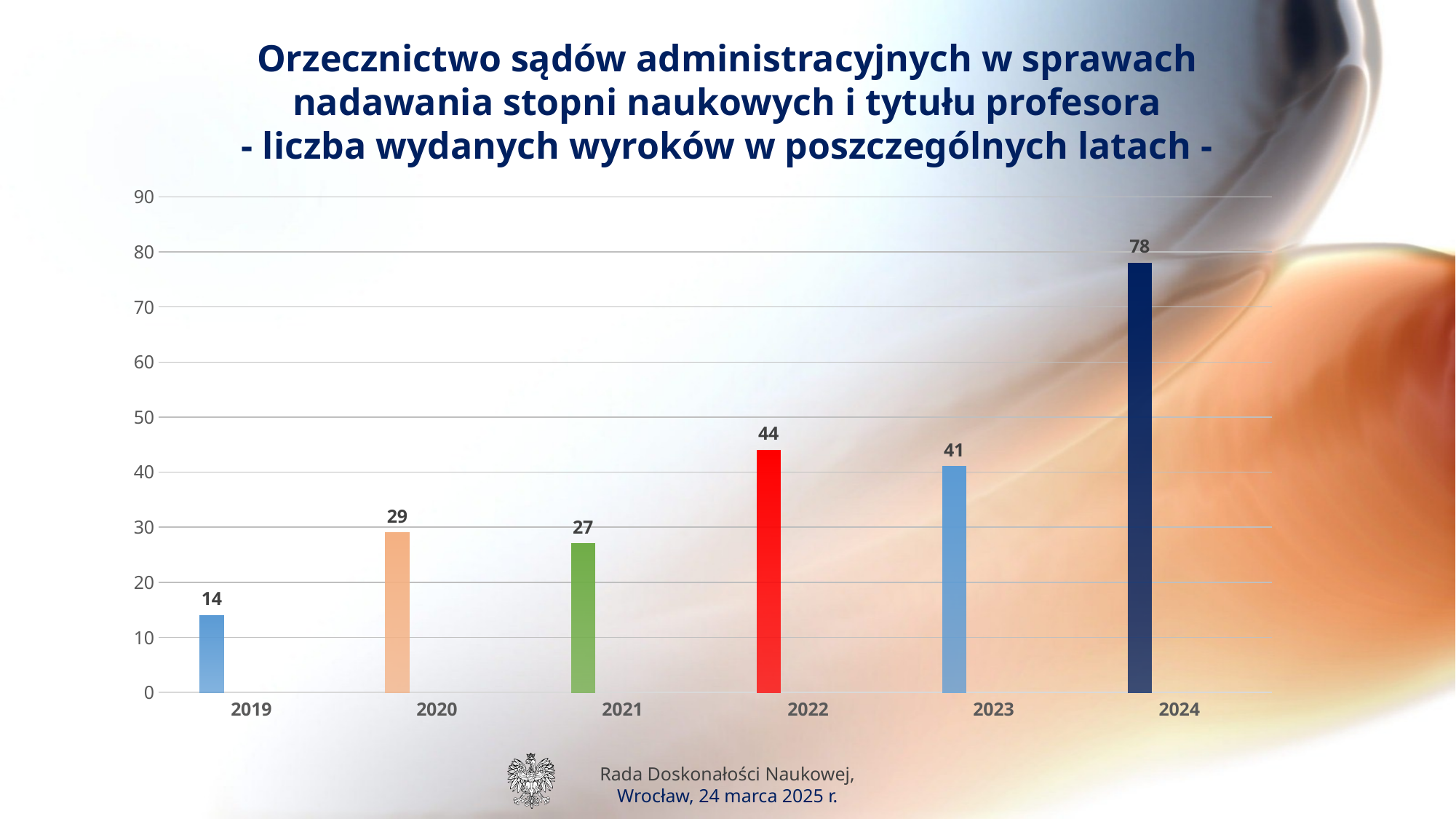
What colour is the bar for 2022? red What is the difference between the values for 2020 and 2021? 2 What kind of chart is shown on the slide? bar chart Is the value for 2024 greater or less than 70? greater Which is larger, the value for 2022 or the value for 2023? 2022 What is the difference between the values for 2024 and 2023? 37 Which year has the lowest value? 2019 Which year has the highest value? 2024 What is the value for 2022? 44 What is the value for 2019? 14 What is the value for 2024? 78 How many years are shown on the x axis? 6